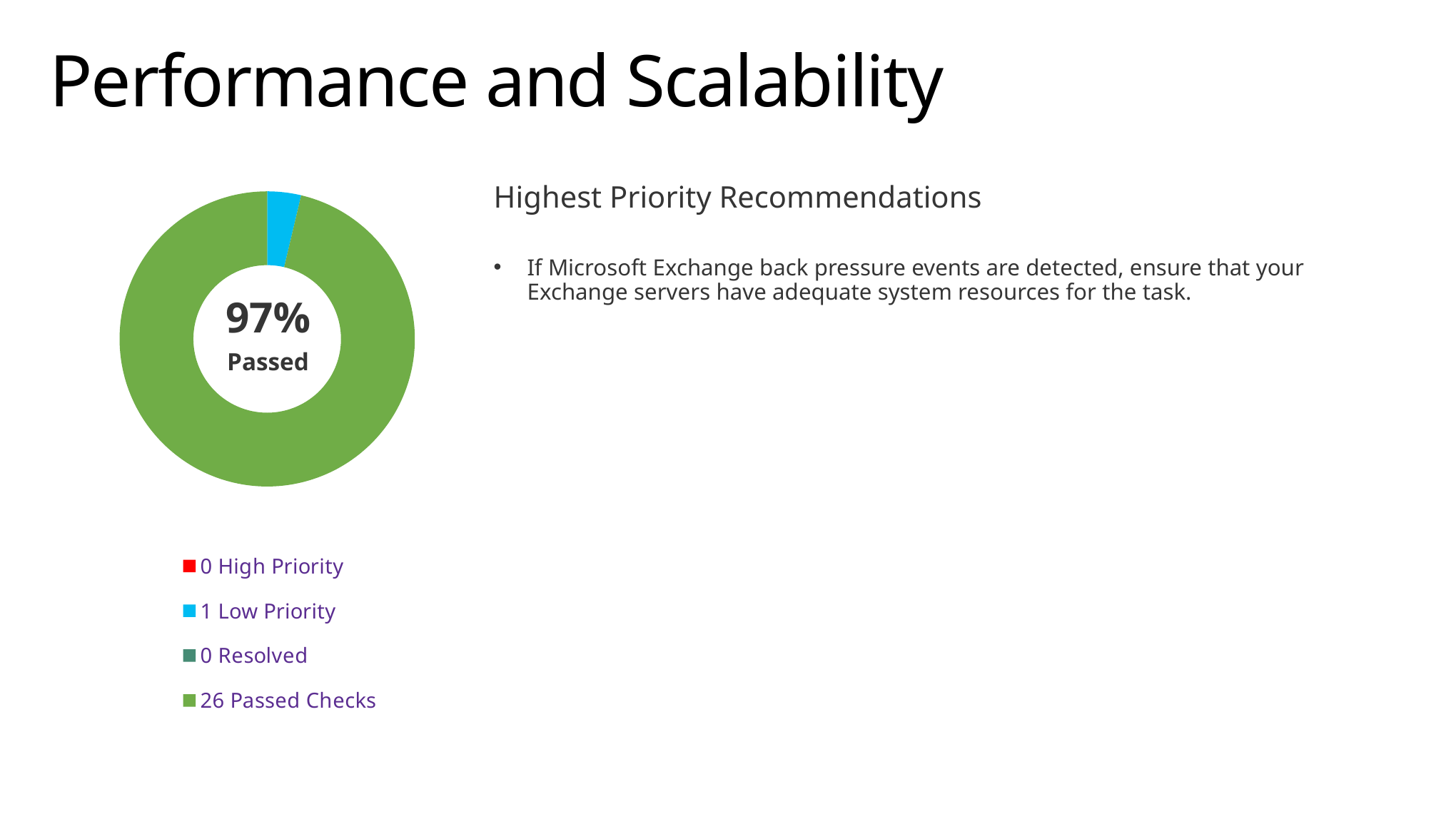
What is the difference between the number of Passed Checks and the number of Low Priority items? 25 What is the total of all the counts listed in the legend? 27 What kind of chart is shown on the slide? Doughnut chart How many Passed Checks does the legend show? 26 How many entries does the legend list? 4 What colour represents Passed Checks in the chart? Green Which category has the highest count in the chart? Passed Checks How many High Priority items does the legend show? 0 What percentage is shown in the centre of the doughnut chart? 97% How many Low Priority items does the legend show? 1 Which is larger, the number of Passed Checks or the number of Low Priority items? Passed Checks How many Resolved items does the legend show? 0